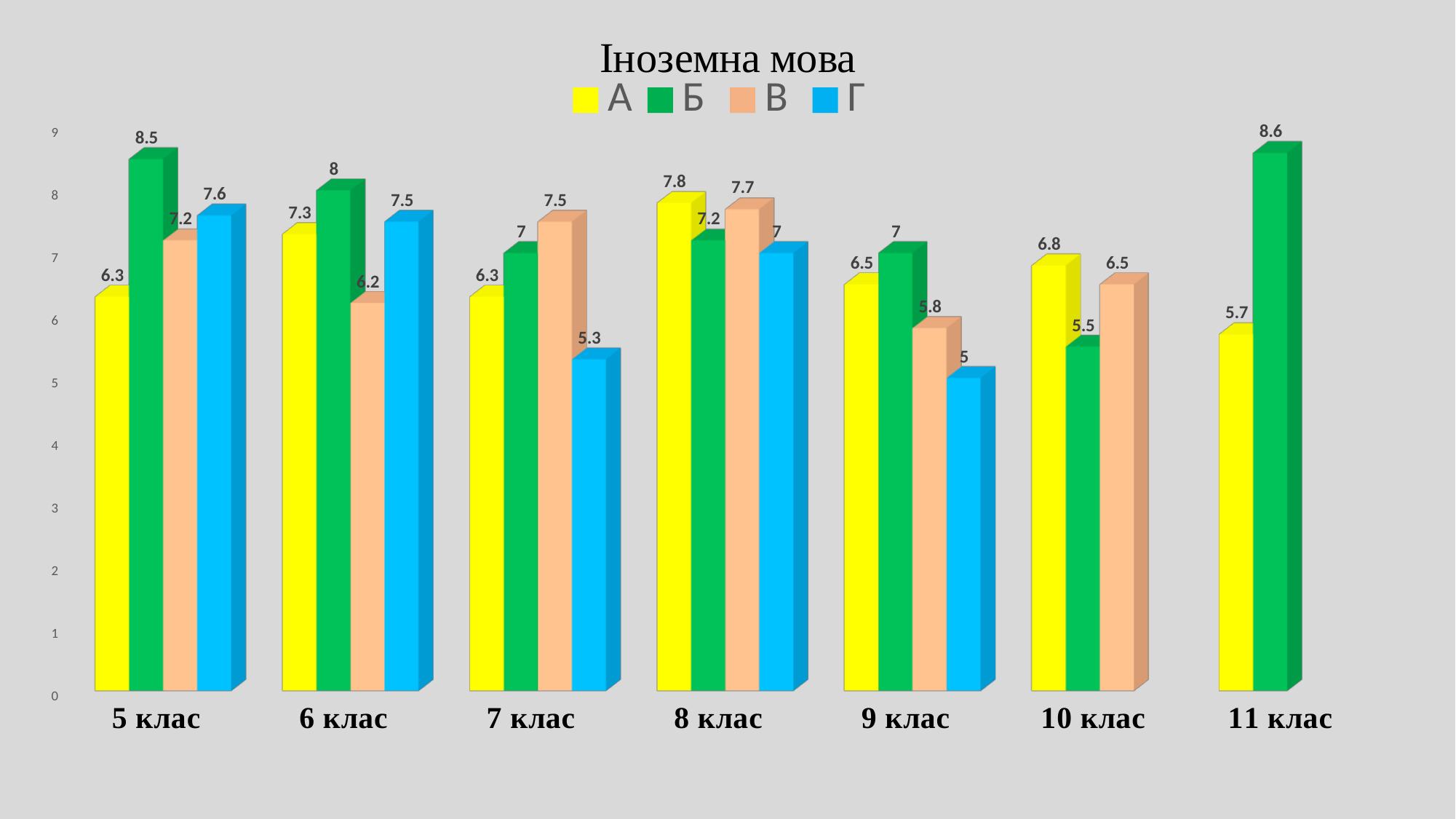
What is the title of the chart? Іноземна мова What kind of chart is shown? bar chart How many series does the legend list? 4 How many class categories are shown on the x axis? 7 Which series has the lowest value in 9 клас? Г What is the value for series В in 10 клас? 6.5 Which is larger in 8 клас: series А or series В? А Which series has the highest value in 11 клас? Б What is the difference between series Б and series А in 5 клас? 2.2 What is the value for series Г in 7 клас? 5.3 What is the value for series Б in 5 клас? 8.5 Which colour represents series Г in the legend? blue